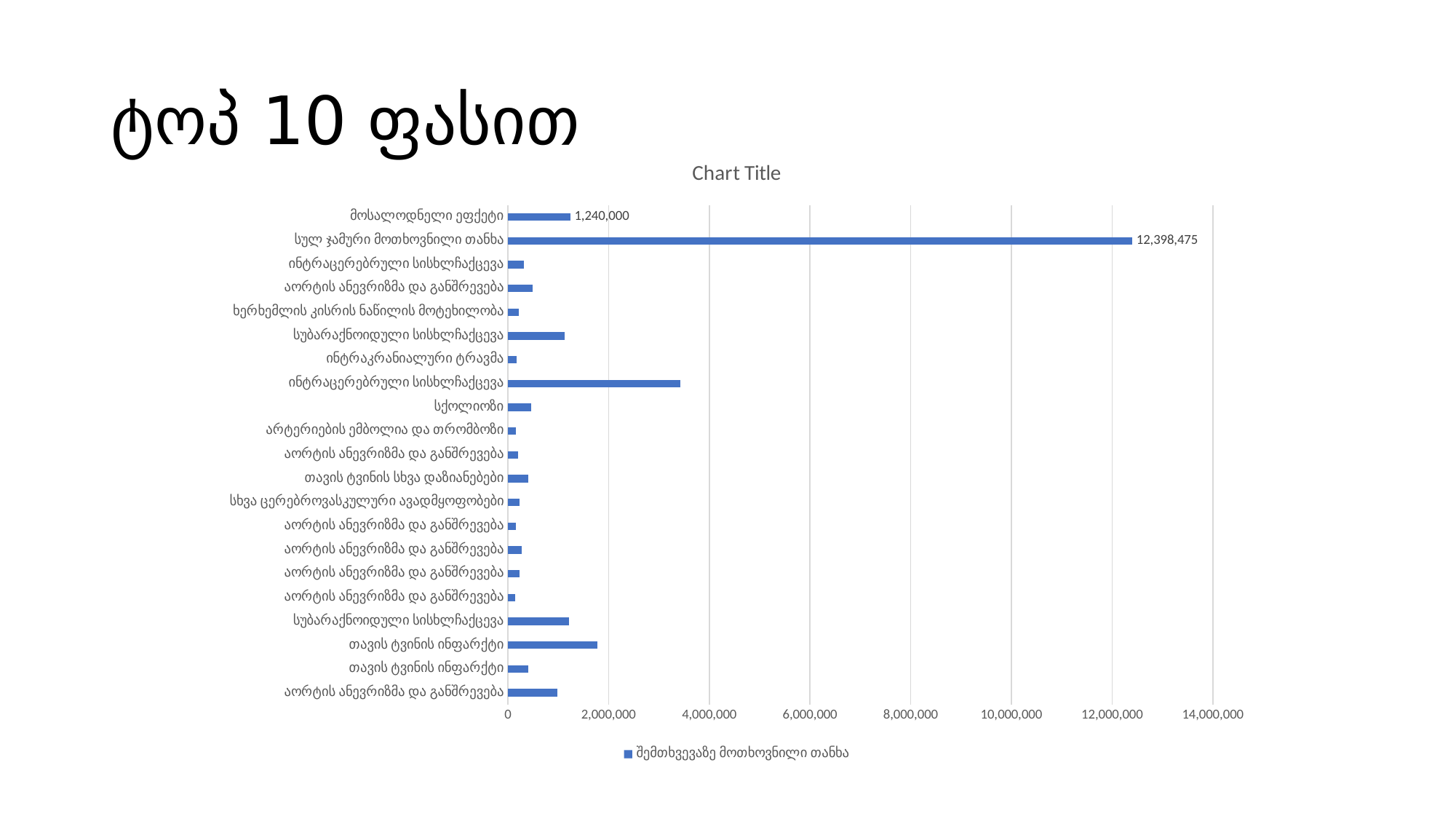
Which category has the highest value? სულ ჯამური მოთხოვნილი თანხა How many categories are plotted in the chart? 21 What is the value for მოსალოდნელი ეფექტი? 1,240,000 Is the value for სქოლიოზი greater or less than 2,000,000? less What is the difference between the values for სულ ჯამური მოთხოვნილი თანხა and მოსალოდნელი ეფექტი? 11,158,475 Is the value for სულ ჯამური მოთხოვნილი თანხა greater or less than 12,000,000? greater What type of chart is shown on the slide? bar chart What is the value for სულ ჯამური მოთხოვნილი თანხა? 12,398,475 Is the value for ინტრაკრანიალური ტრავმა greater or less than 2,000,000? less Which is larger: the value for მოსალოდნელი ეფექტი or the value for სქოლიოზი? მოსალოდნელი ეფექტი What is the legend entry of the chart? შემთხვევაზე მოთხოვნილი თანხა How many series does the legend list? 1